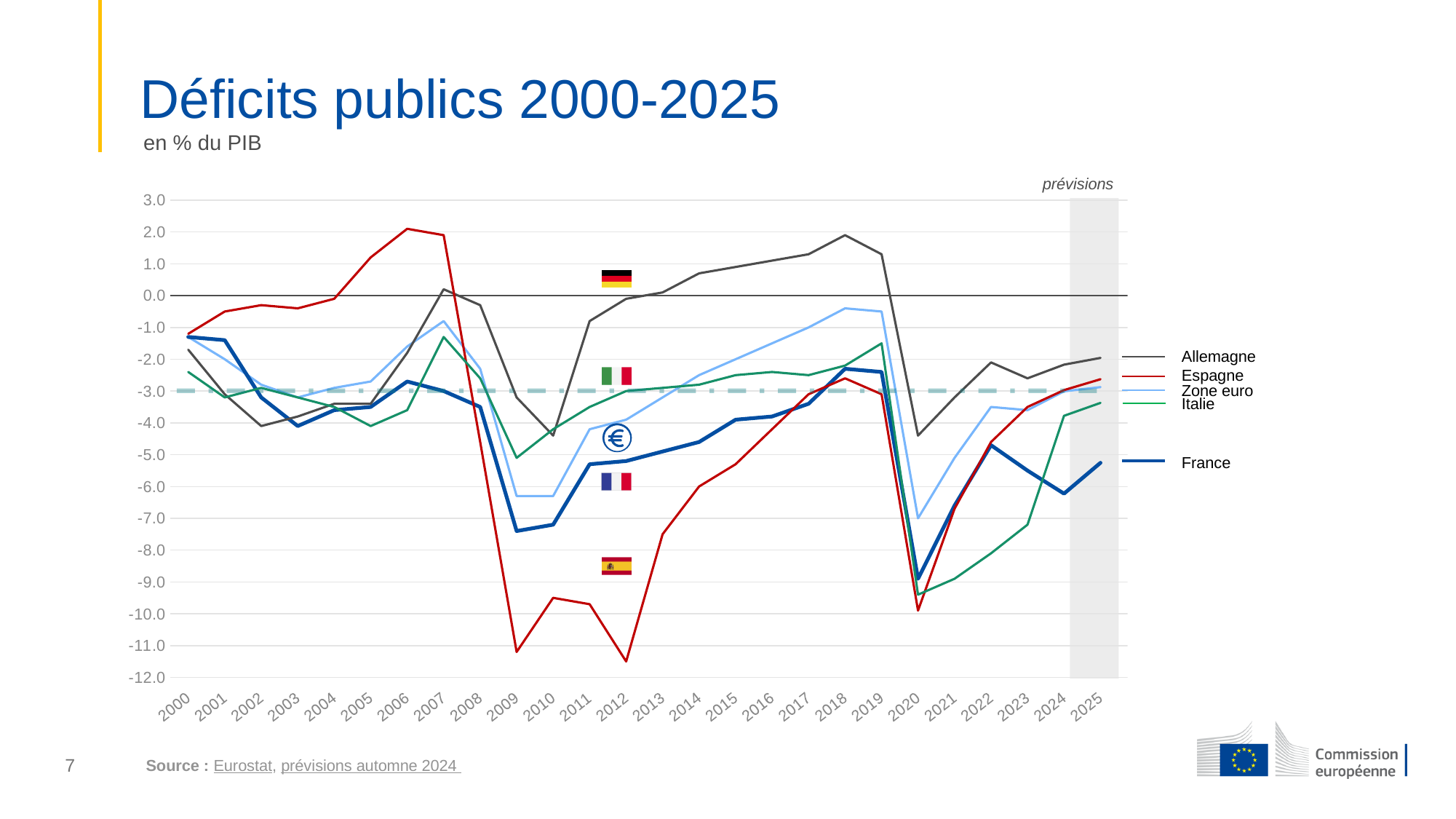
Does the Espagne line rise or fall between 2012 and 2018? rise In 2025, which is higher, France or Zone euro? Zone euro Is the value for France in 2009 greater or less than -7.0? less Which series has the highest value in 2018? Allemagne Is the value for Zone euro in 2020 greater or less than -6.0? less Which series reaches the lowest value anywhere on the chart? Espagne Is the value for Allemagne in 2018 greater or less than 1.0? greater Which years are shaded as 'prévisions' on the chart? 2024 and 2025 In 2020, which is lower, Espagne or France? Espagne What kind of chart is shown on the slide? line chart How many series does the legend list? 5 How many years are plotted along the x axis? 26